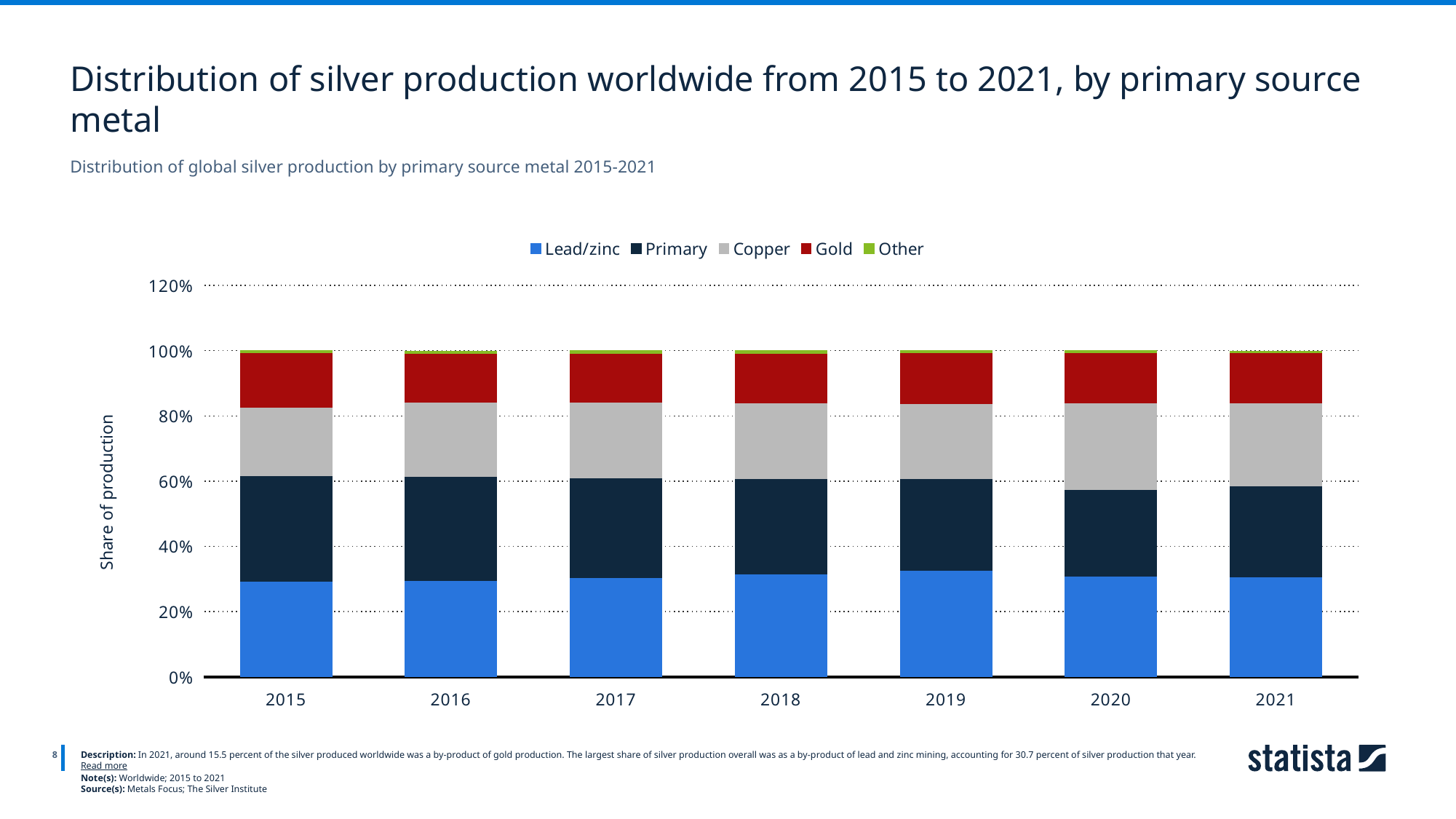
How many series does the chart's legend list? 5 In 2021, which is larger: the Gold segment or the Other segment? Gold Which series has the smallest share of production in every year shown? Other How many years are shown on the x axis of the chart? 7 What kind of chart is shown on the slide? Stacked bar chart In 2015, which is larger: the Primary segment or the Copper segment? Primary Is the Lead/zinc share of production in 2019 greater or less than 20%? greater According to the description on the slide, what share of silver production in 2021 was a by-product of lead and zinc mining? 30.7 percent Is the Lead/zinc share of production in 2015 greater or less than 40%? less What colour represents Gold in the chart's legend? Red Which is larger: the Lead/zinc share in 2019 or the Lead/zinc share in 2015? 2019 What is the label on the chart's y axis? Share of production